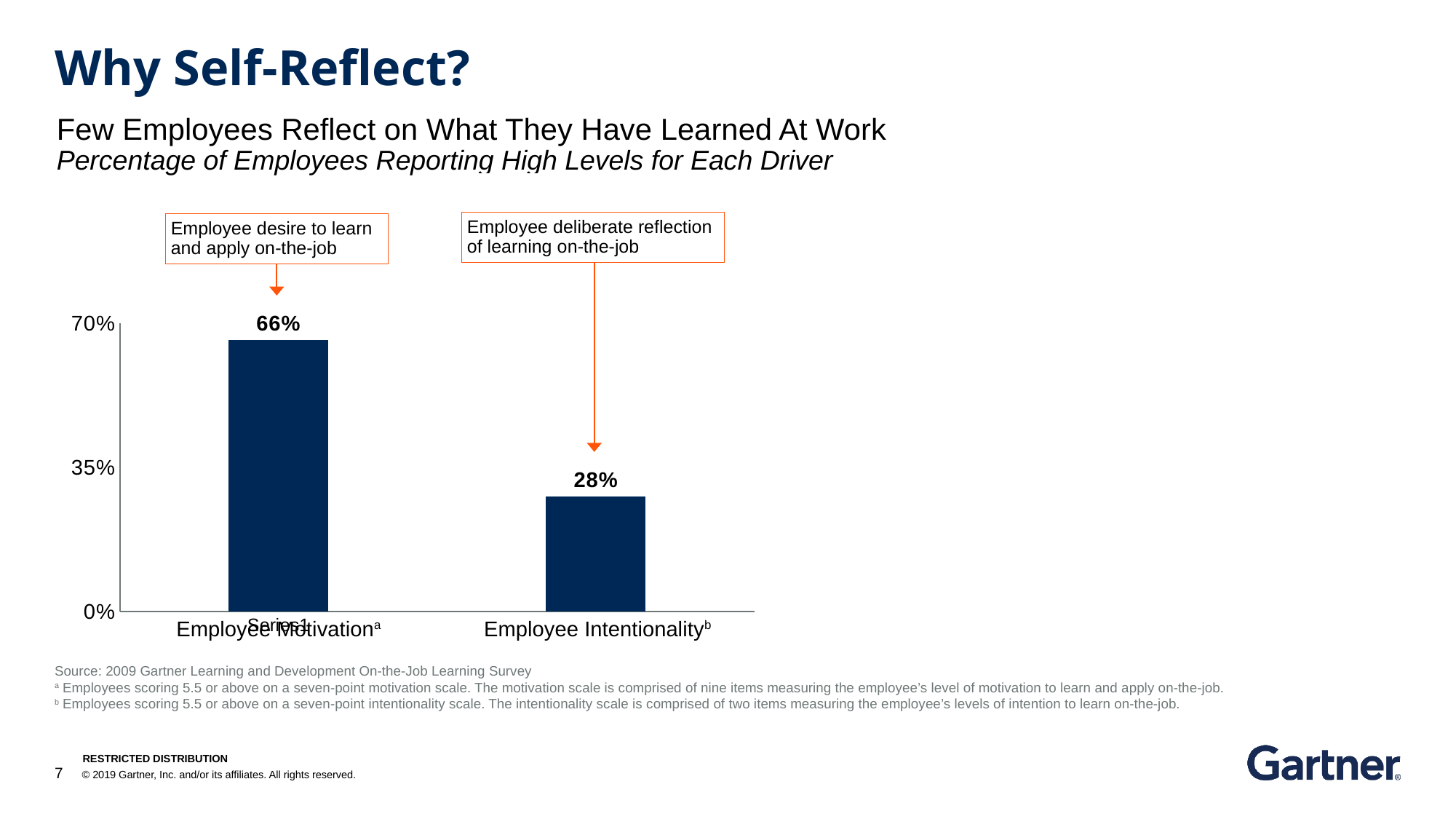
According to the callout box, what does Employee Intentionality represent? Employee deliberate reflection of learning on-the-job Which category has the higher value, Employee Motivation or Employee Intentionality? Employee Motivation What percentage of employees report high levels of Employee Intentionality? 28% What is the difference in percentage points between Employee Motivation and Employee Intentionality? 38 percentage points What percentage of employees report high levels of Employee Motivation? 66% Which category has the lowest value in the chart? Employee Intentionality How many categories are plotted in the chart? 2 Is the value for Employee Motivation greater or less than 35%? greater What type of chart is shown on the slide? Bar chart What is the highest value shown on the chart's vertical axis? 70% Which category has the highest value in the chart? Employee Motivation Is the value for Employee Intentionality greater or less than 35%? less